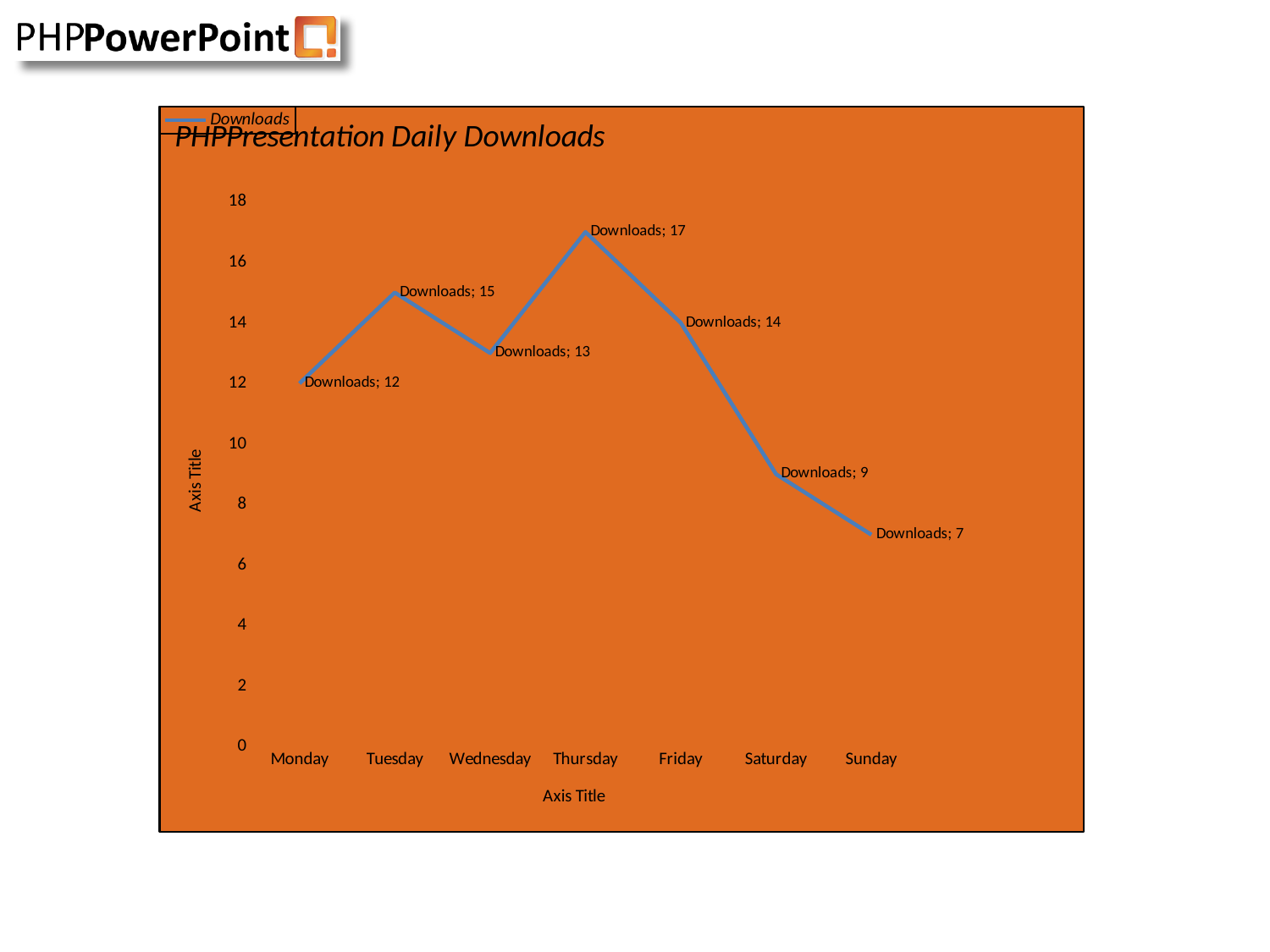
What is the value for Downloads on Thursday? 17 Is the value for Saturday greater or less than 10? less Which day has more downloads, Tuesday or Friday? Tuesday What is the value for Downloads on Monday? 12 What is the difference between the downloads on Thursday and on Sunday? 10 What is the title of the chart? PHPPresentation Daily Downloads Which day has the highest number of downloads? Thursday What kind of chart is shown on the slide? line chart Which day has the lowest number of downloads? Sunday What is the value for Downloads on Sunday? 7 How many days are plotted on the x axis? 7 How many series does the legend list? 1